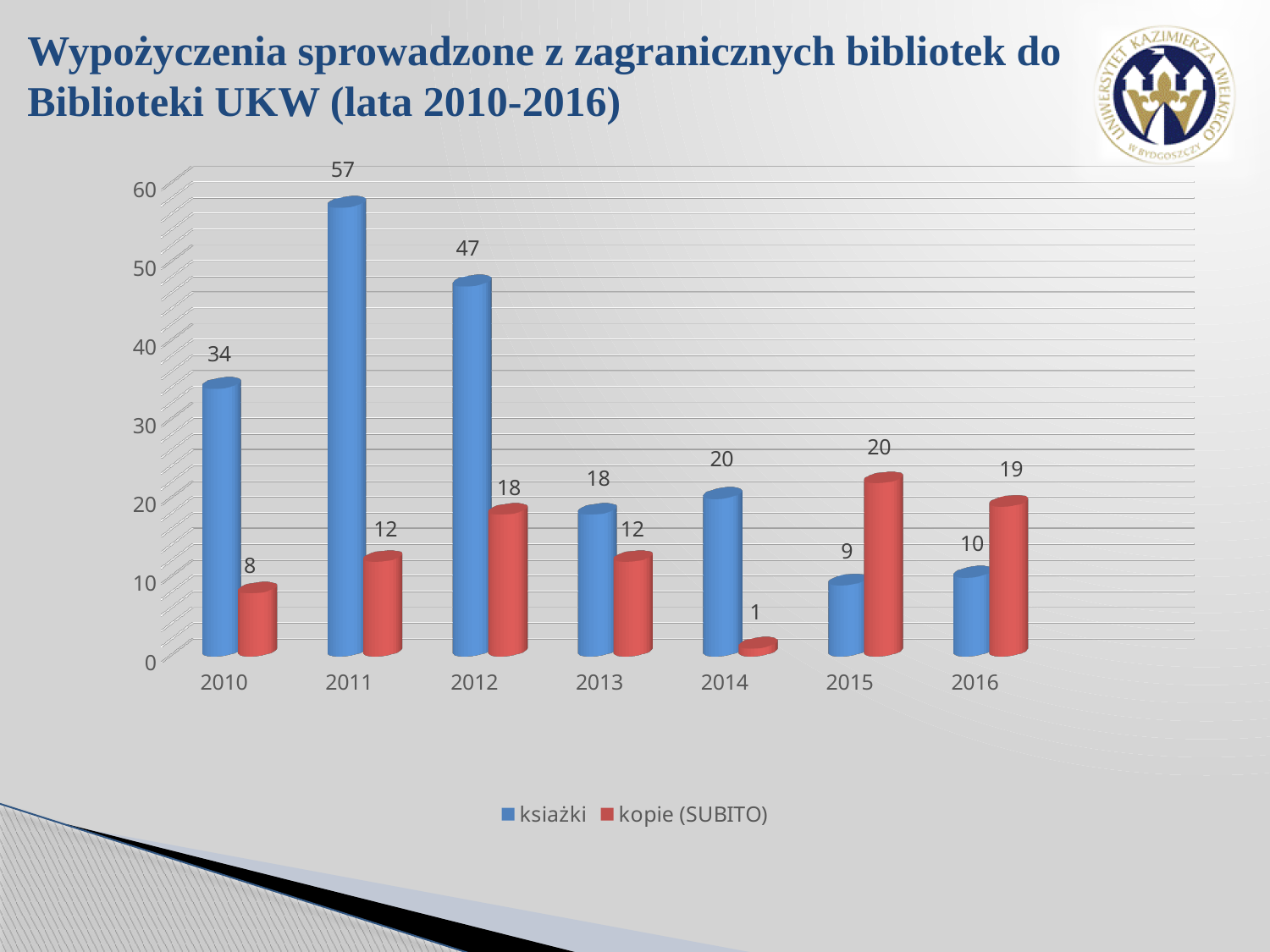
Which is larger in 2015, ksiażki or kopie (SUBITO)? kopie (SUBITO) In which year is the ksiażki value highest? 2011 What is the value for kopie (SUBITO) in 2016? 19 What is the difference between the ksiażki and kopie (SUBITO) values in 2012? 29 How many series does the legend list? 2 What kind of chart is shown on the slide? bar chart What colour are the kopie (SUBITO) bars? red What is the value for kopie (SUBITO) in 2014? 1 What is the value for ksiażki in 2011? 57 In which year is the kopie (SUBITO) value lowest? 2014 Do the ksiażki values rise or fall from 2011 to 2015? fall How many years are shown on the x axis? 7